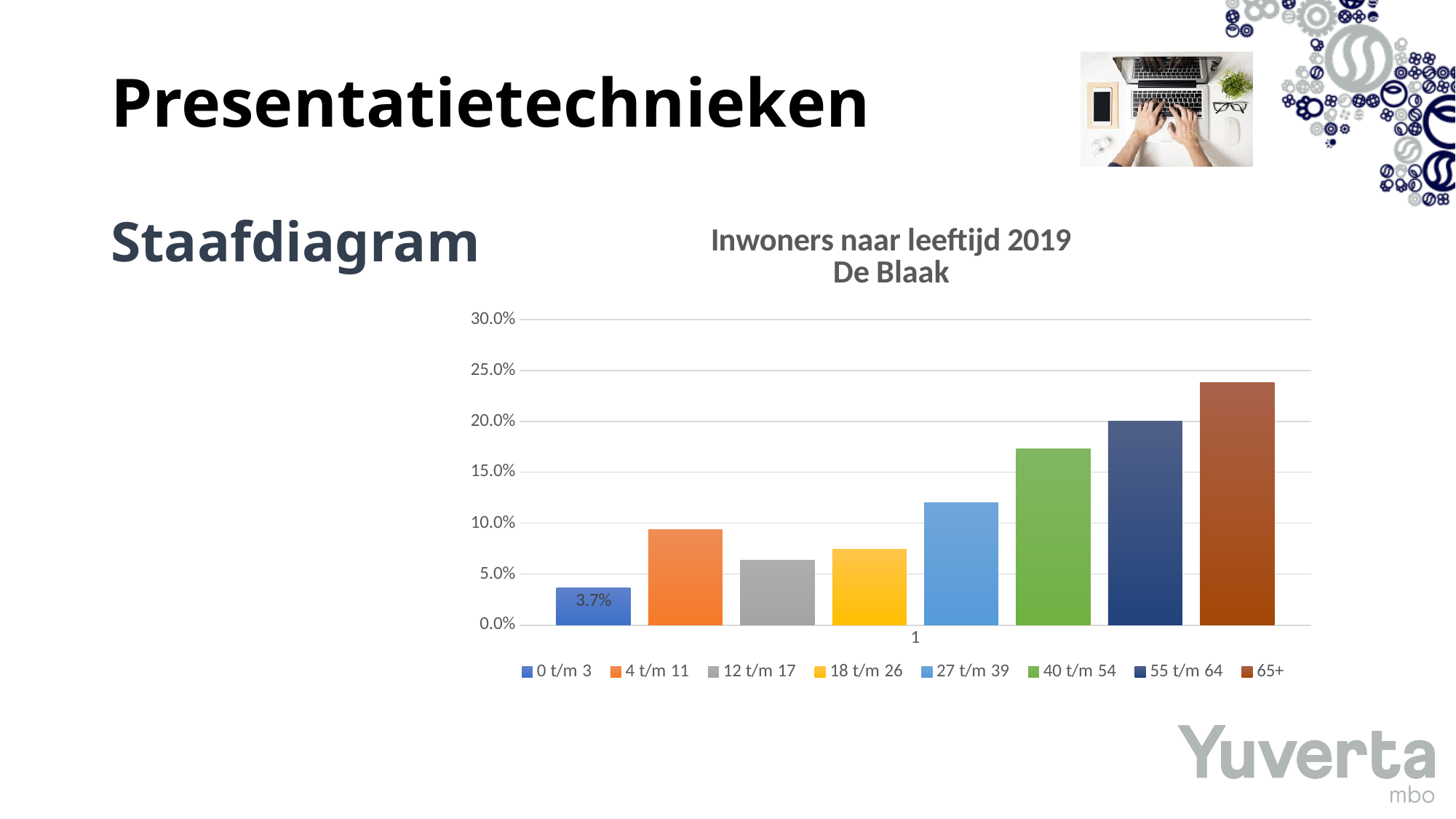
Which is larger, the bar for 4 t/m 11 or the bar for 12 t/m 17? 4 t/m 11 Which age group has the highest bar? 65+ Is the value for 40 t/m 54 greater or less than 15.0%? greater Which age group has the lowest bar? 0 t/m 3 What is the title of the chart? Inwoners naar leeftijd 2019 De Blaak What kind of chart is shown on the slide? Bar chart Is the value for 18 t/m 26 greater or less than 10.0%? less Is the value for 27 t/m 39 greater or less than 15.0%? less Which is larger, the bar for 55 t/m 64 or the bar for 40 t/m 54? 55 t/m 64 How many series does the legend list? 8 What is the value shown for the 0 t/m 3 series? 3.7%